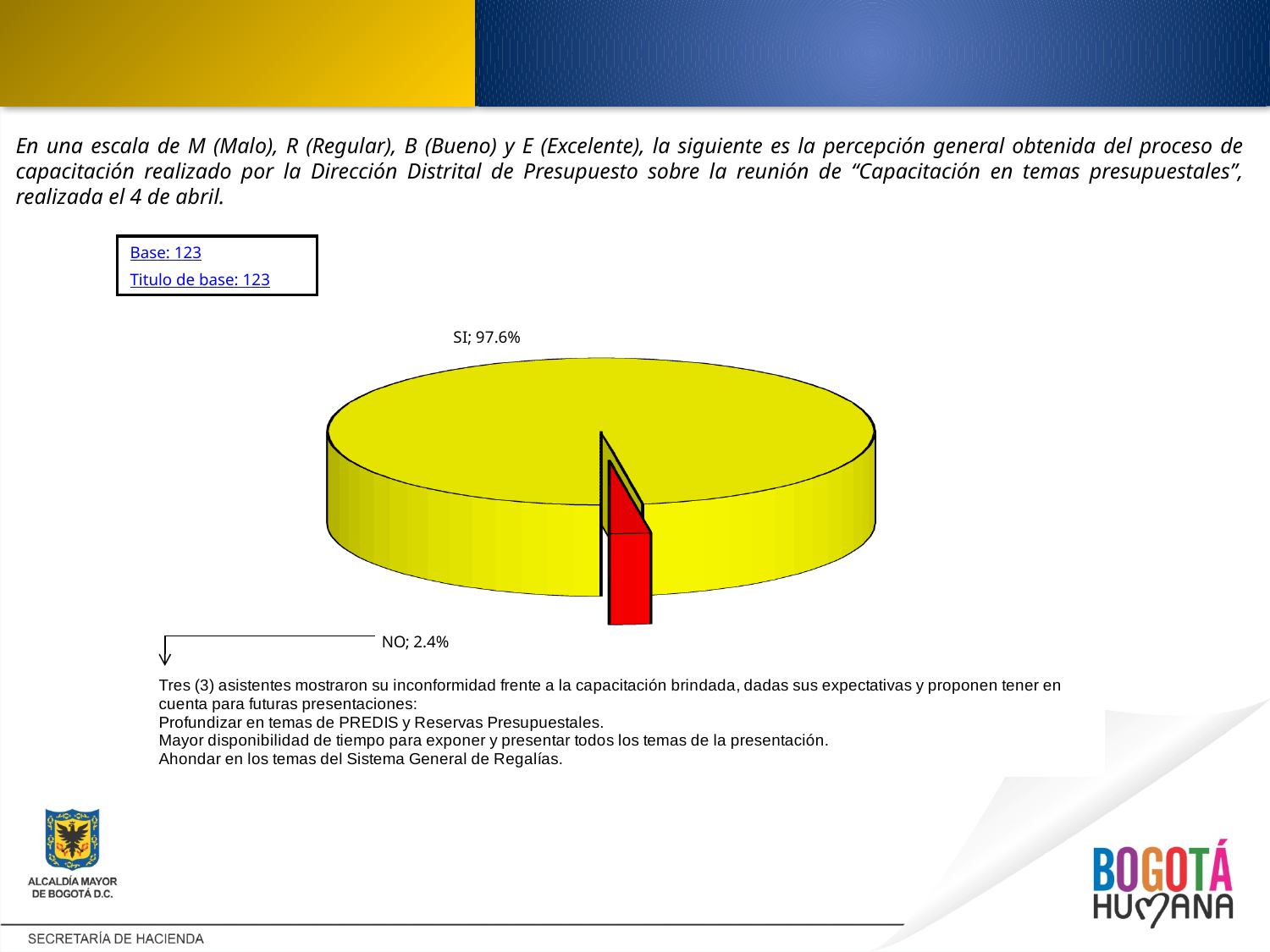
Which slice of the pie is the largest? SI Which is larger, the SI slice or the NO slice? SI What kind of chart is shown on the slide? pie chart What share of the pie does the NO slice represent? 2.4% What colour is the NO slice of the pie? red How many slices does the pie chart have? 2 What is the value shown for the NO slice? 2.4% What is the difference between the SI and NO percentages? 95.2% What colour is the SI slice of the pie? yellow Which slice of the pie is the smallest? NO What is the value shown for the SI slice? 97.6%